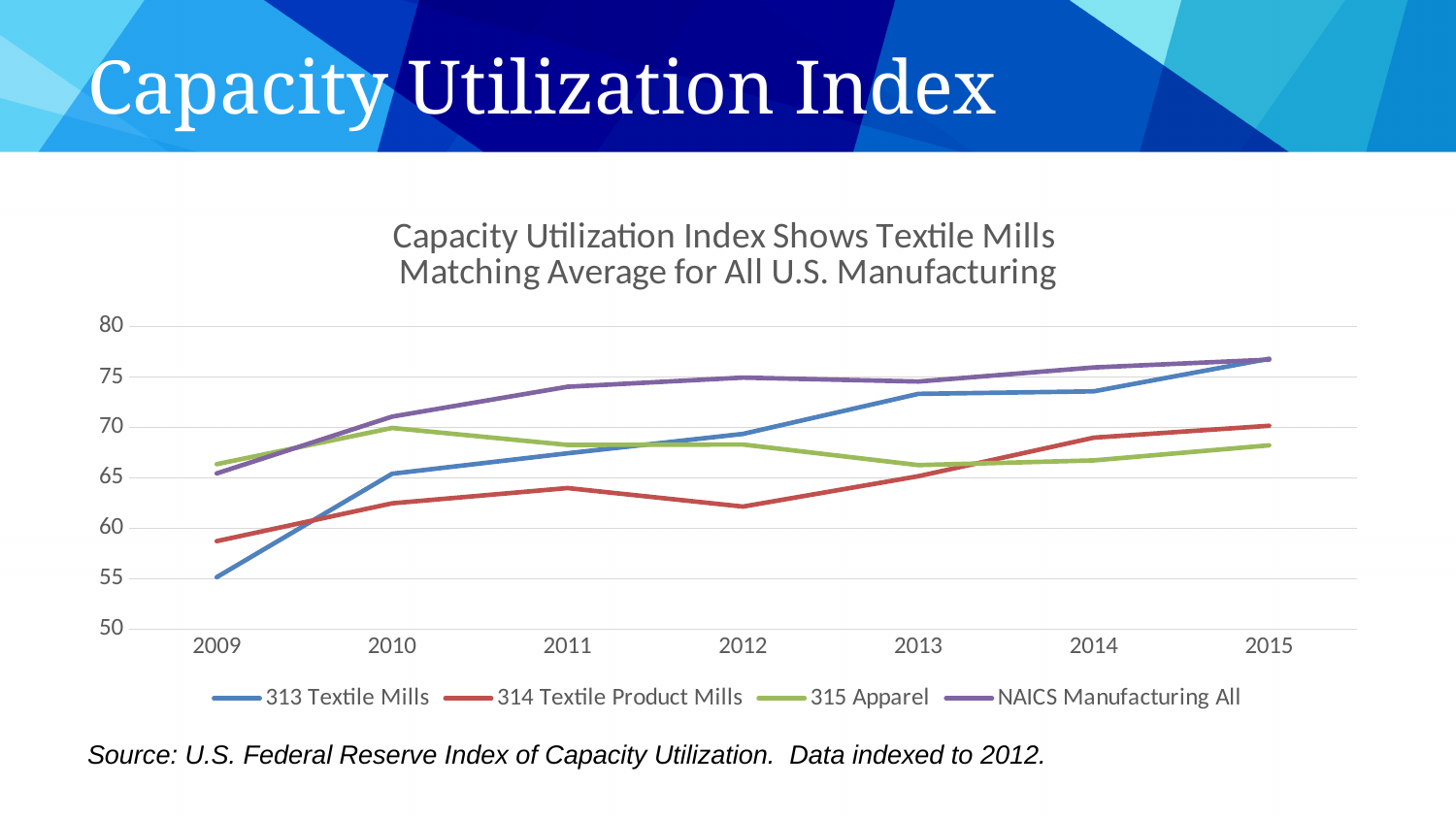
In 2009, which is larger: 315 Apparel or 313 Textile Mills? 315 Apparel How many series does the legend list? 4 Does the 313 Textile Mills line rise or fall from 2009 to 2015? rise Which series has the lowest value in 2013? 314 Textile Product Mills Is the value for 314 Textile Product Mills in 2015 greater or less than 65? greater Is the value for NAICS Manufacturing All in 2012 greater or less than 70? greater How many years are shown on the x axis? 7 What is the title of the chart? Capacity Utilization Index Shows Textile Mills Matching Average for All U.S. Manufacturing Which series has the lowest value in 2009? 313 Textile Mills What colour is the 315 Apparel line? green Is the value for 313 Textile Mills in 2009 greater or less than 60? less What kind of chart is shown on the slide? line chart